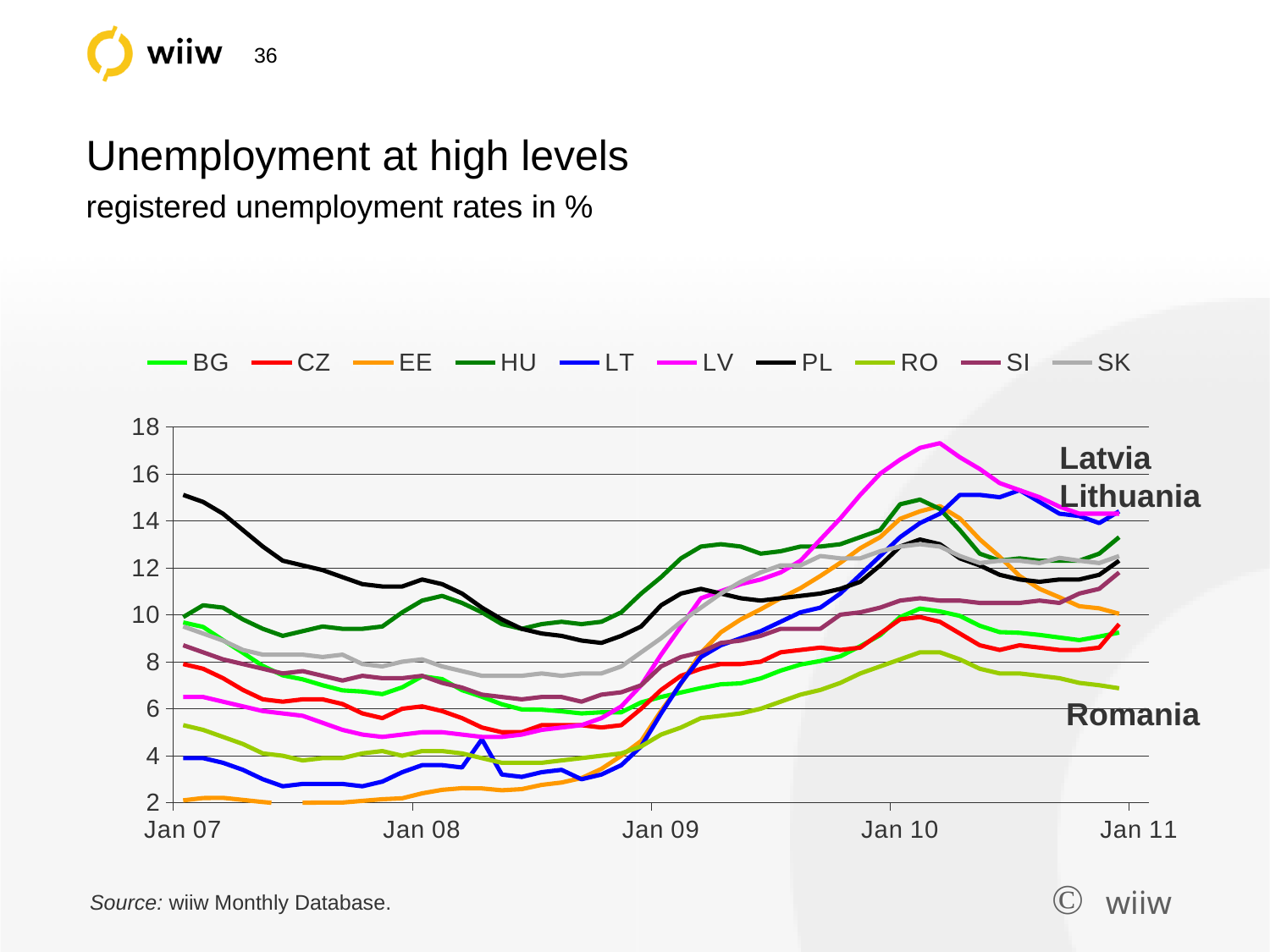
Is the value for PL at Jan 07 greater or less than 14? greater Which series has the highest value at Jan 07? PL What unit are the registered unemployment rates shown in, according to the subtitle? % Which series has the lowest value at Jan 11? RO How many series does the legend list? 10 What kind of chart is shown on the slide? line chart What is the title of the chart on the slide? Unemployment at high levels Does the LV series rise or fall between Jan 09 and Jan 10? rise At Jan 11, which is larger, the value for LV or the value for RO? LV Which series has the lowest value at Jan 07? EE Is the value for RO at Jan 11 greater or less than 8? less Which series reaches the highest peak on the chart? LV